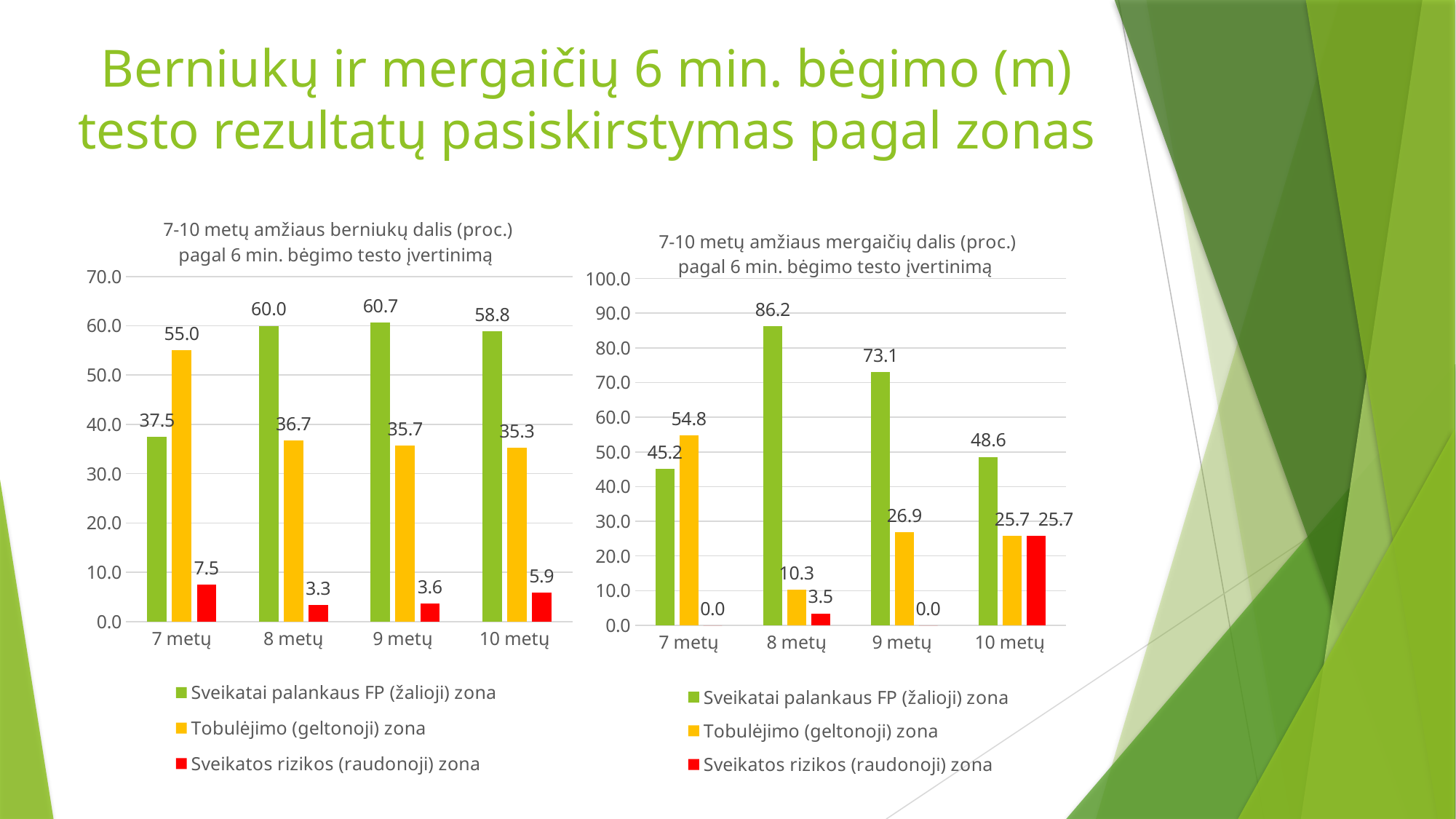
In the left chart (7-10 metų amžiaus berniukų dalis), what is the difference between the Tobulėjimo (geltonoji) zona value for 7 metų and for 8 metų? 18.3 In the left chart (7-10 metų amžiaus berniukų dalis), which age group has the lowest value for the Sveikatos rizikos (raudonoji) zona series? 8 metų What type of chart is the left chart (7-10 metų amžiaus berniukų dalis)? Bar chart How many series does the legend of the right chart (7-10 metų amžiaus mergaičių dalis) list? 3 In the right chart (7-10 metų amžiaus mergaičių dalis), what is the difference between the Sveikatai palankaus FP (žalioji) zona value for 8 metų and for 10 metų? 37.6 In the right chart (7-10 metų amžiaus mergaičių dalis), which age group has the highest value for the Sveikatai palankaus FP (žalioji) zona series? 8 metų In the left chart (7-10 metų amžiaus berniukų dalis), what is the value of the Sveikatai palankaus FP (žalioji) zona series for 8 metų? 60.0 In the right chart (7-10 metų amžiaus mergaičių dalis), what is the value of the Tobulėjimo (geltonoji) zona series for 9 metų? 26.9 How many age groups are shown on the x axis of the left chart (7-10 metų amžiaus berniukų dalis)? 4 In the left chart (7-10 metų amžiaus berniukų dalis), which colour represents the Sveikatos rizikos (raudonoji) zona series? Red In the right chart (7-10 metų amžiaus mergaičių dalis), which is larger for 7 metų: the Sveikatai palankaus FP (žalioji) zona value or the Tobulėjimo (geltonoji) zona value? Tobulėjimo (geltonoji) zona In the right chart (7-10 metų amžiaus mergaičių dalis), what is the value of the Sveikatos rizikos (raudonoji) zona series for 10 metų? 25.7